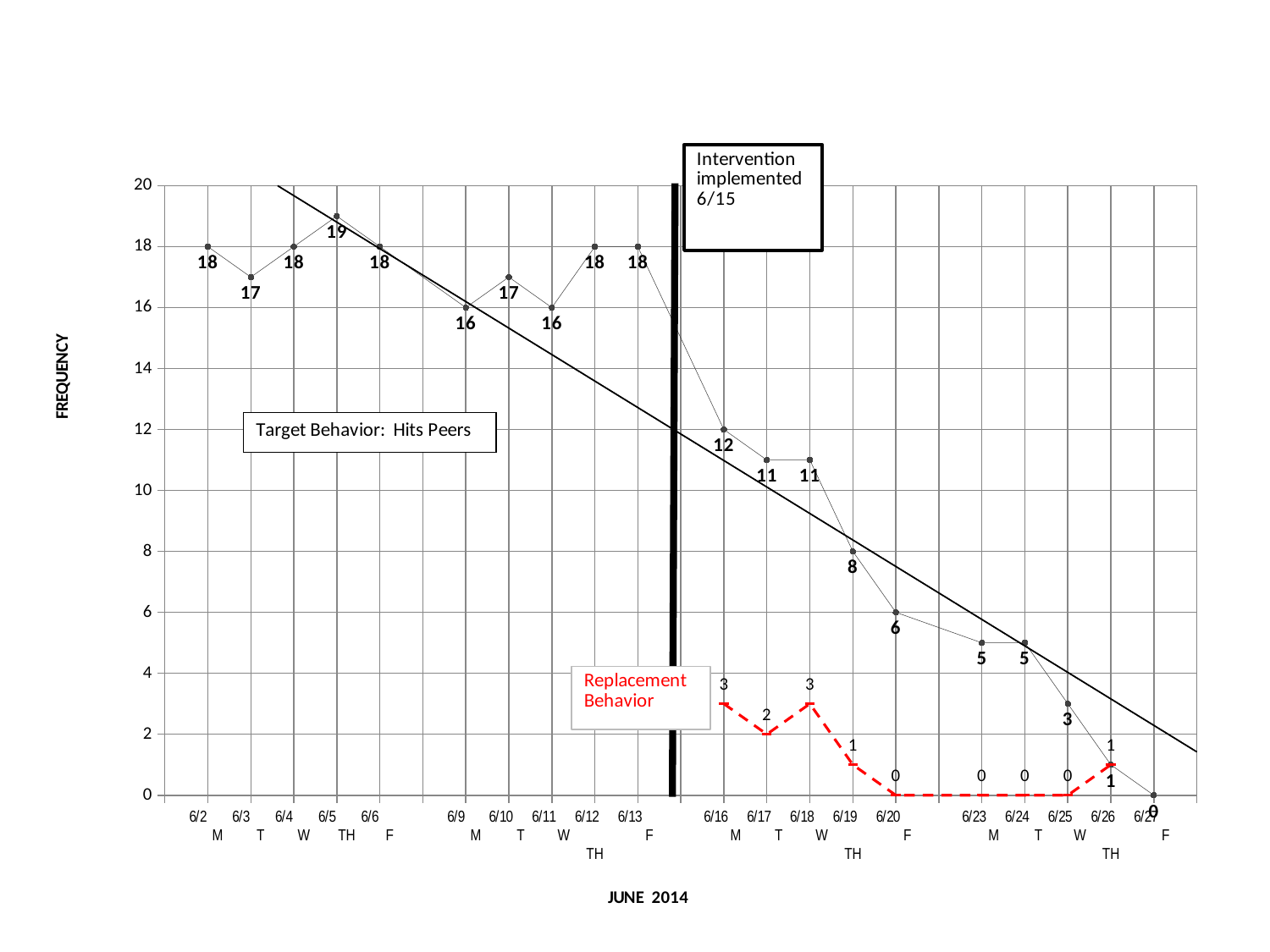
What kind of chart is shown on the slide? Line chart Does the Target Behavior frequency rise or fall from 6/16 to 6/27? Fall On 6/19, which is larger: the Target Behavior frequency or the Replacement Behavior frequency? Target Behavior On which date does the Target Behavior (Hits Peers) line reach its highest value? 6/5 What is the Target Behavior frequency on 6/27? 0 What is the Replacement Behavior frequency on 6/17? 2 What is the label on the vertical axis? FREQUENCY On what date was the intervention implemented, according to the annotation? 6/15 What is the Target Behavior (Hits Peers) frequency on 6/5? 19 How many dates are plotted for the Target Behavior (Hits Peers) line? 20 What is the Target Behavior frequency on 6/16, the first day after the intervention? 12 What is the difference between the Target Behavior frequency on 6/13 and on 6/16? 6